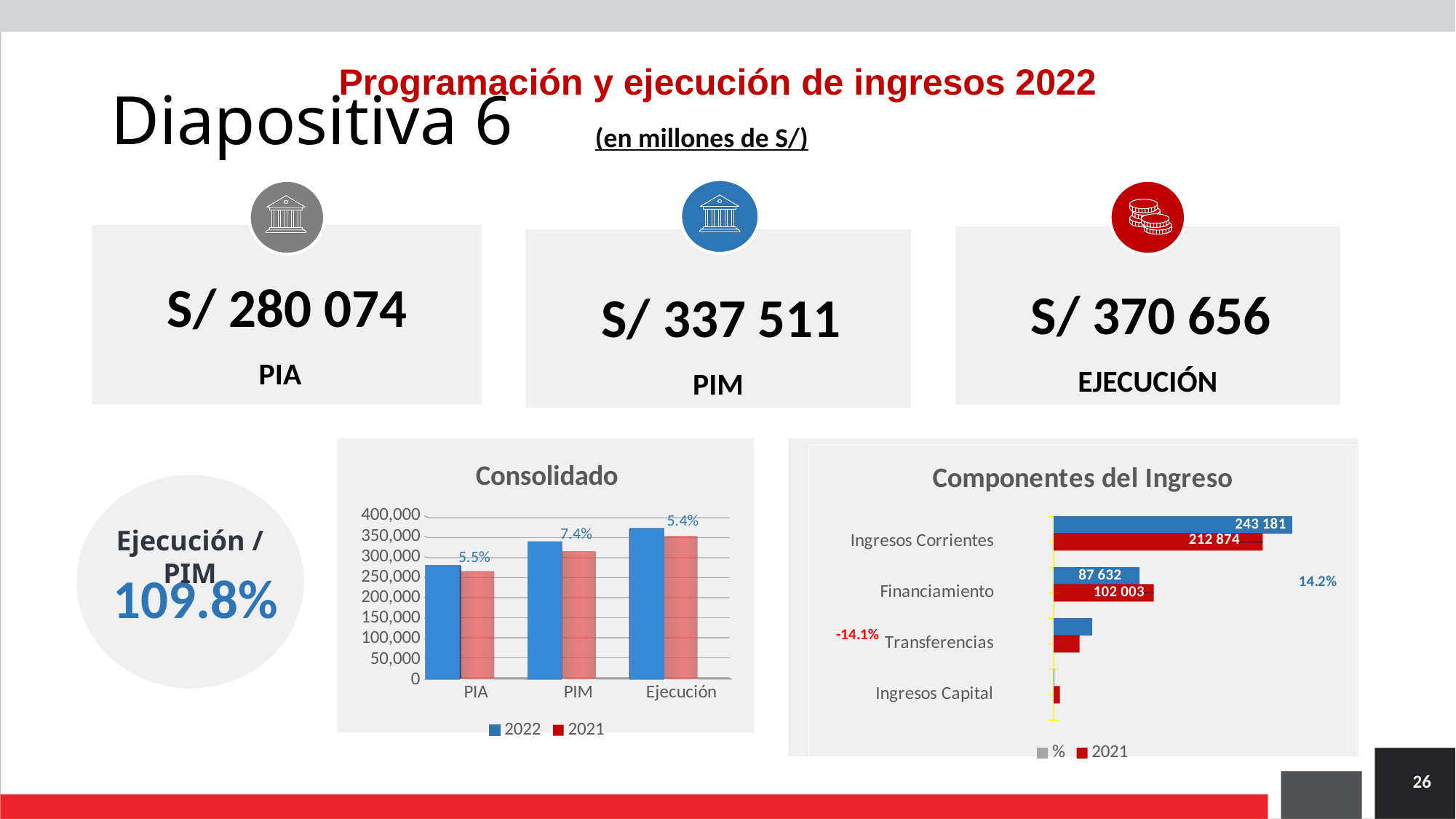
In the "Consolidado" chart, is the 2022 value for PIA greater or less than 250,000? greater In the "Consolidado" chart, is the 2021 value for PIM greater or less than 350,000? less In the "Componentes del Ingreso" chart, what is the difference between the blue and red bars for Ingresos Corrientes? 30 307 In the "Consolidado" chart, is the 2022 value for Ejecución greater or less than 350,000? greater In the "Componentes del Ingreso" chart, what is the value of the red (2021) bar for Financiamiento? 102 003 In the "Consolidado" chart, do the 2022 values rise or fall from PIA to Ejecución? rise In the "Componentes del Ingreso" chart, what is the value of the blue bar for Ingresos Corrientes? 243 181 In the "Componentes del Ingreso" chart, which bar is larger for Financiamiento, the blue bar or the red (2021) bar? the red (2021) bar In the "Componentes del Ingreso" chart, which category has the lowest values? Ingresos Capital How many categories are shown on the x axis of the "Consolidado" chart? 3 What type of chart is the "Consolidado" chart? bar chart How many series does the legend of the "Consolidado" chart list? 2